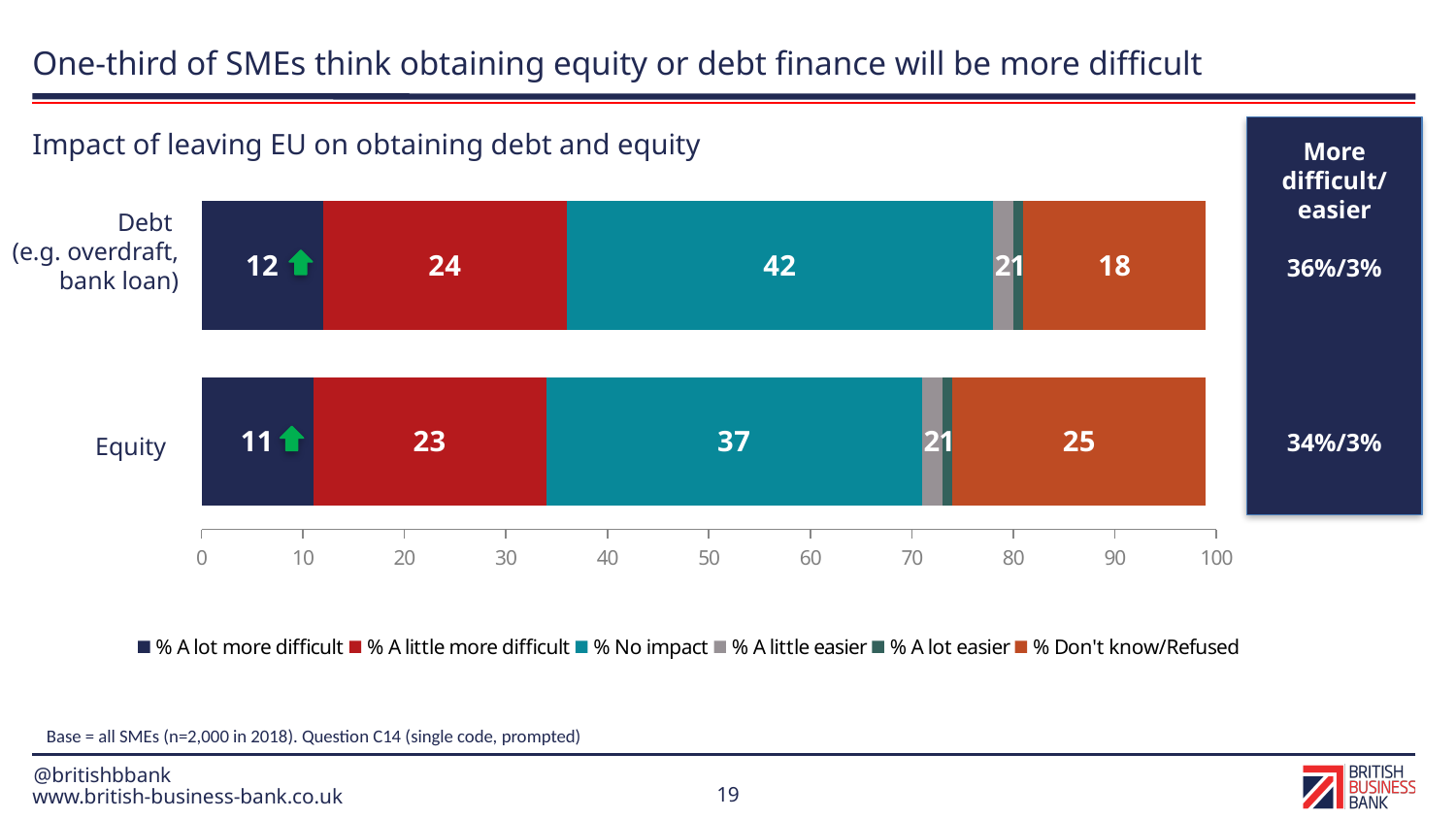
What is the difference between the '% Don't know/Refused' values for Equity and Debt? 7 What is the value for '% A little more difficult' for Equity? 23 Which series has the largest value within the Equity bar? % No impact Which category has the higher value for '% No impact', Debt or Equity? Debt What is the value for '% No impact' for Debt? 42 How many series does the legend list? 6 What is the value for '% Don't know/Refused' for Equity? 25 What is the value for '% A lot more difficult' for Debt? 12 What is the title of the chart? Impact of leaving EU on obtaining debt and equity How many categories are plotted on the chart? 2 What kind of chart is shown on the slide? Stacked bar chart What is the combined value of '% A lot more difficult' and '% A little more difficult' for Debt? 36